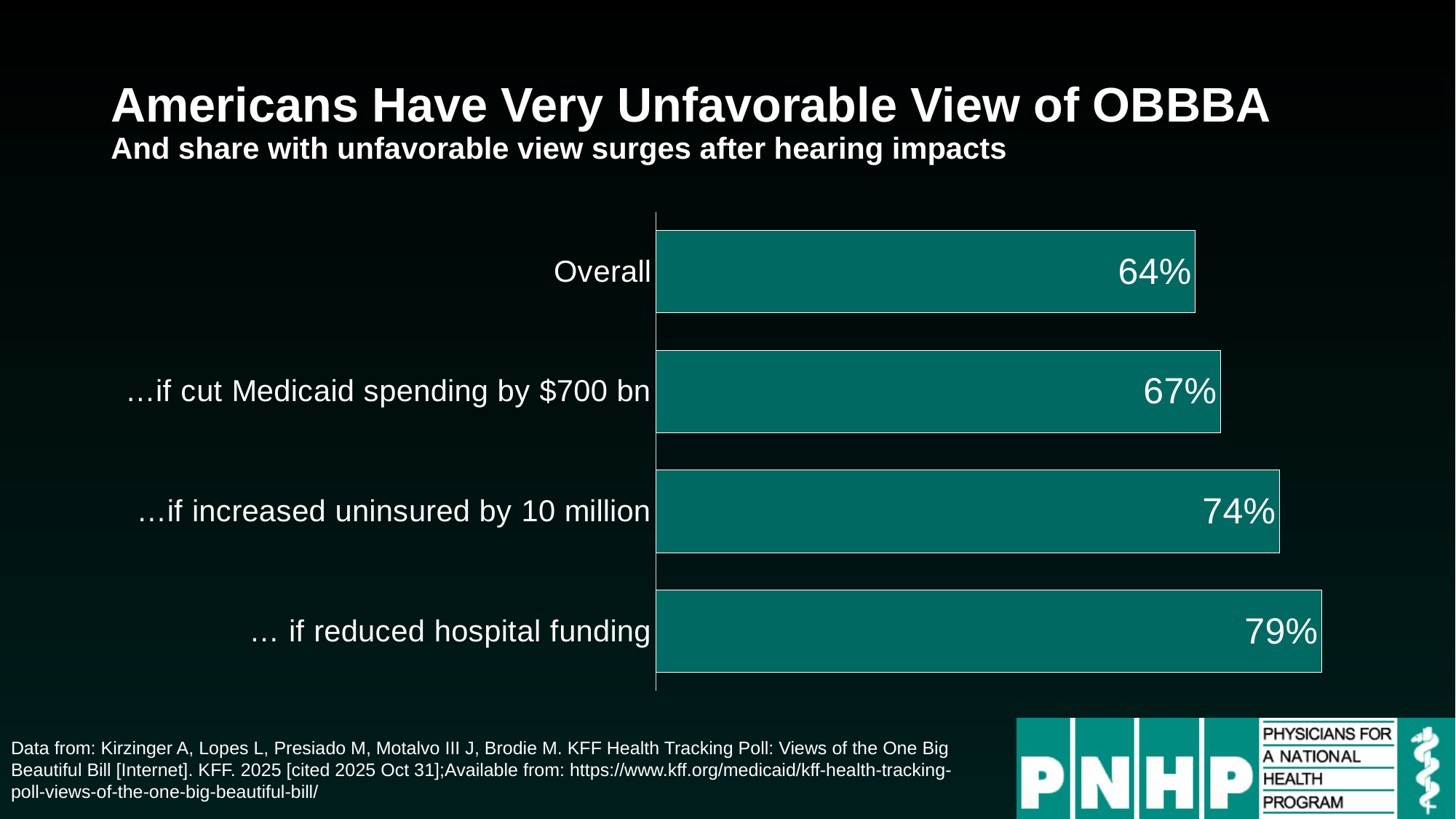
What kind of chart is shown on the slide? Bar chart Which category has the highest value? … if reduced hospital funding What is the value for Overall? 64% What is the difference between the value for "…if increased uninsured by 10 million" and the value for "…if cut Medicaid spending by $700 bn"? 7% What is the difference between the value for "… if reduced hospital funding" and the value for Overall? 15% What is the value for "…if increased uninsured by 10 million"? 74% What is the value for "…if cut Medicaid spending by $700 bn"? 67% Which is larger, the value for "…if increased uninsured by 10 million" or the value for "…if cut Medicaid spending by $700 bn"? …if increased uninsured by 10 million Which category has the lowest value? Overall What is the value for "… if reduced hospital funding"? 79% How many categories are shown in the chart? 4 What is the title of the slide? Americans Have Very Unfavorable View of OBBBA